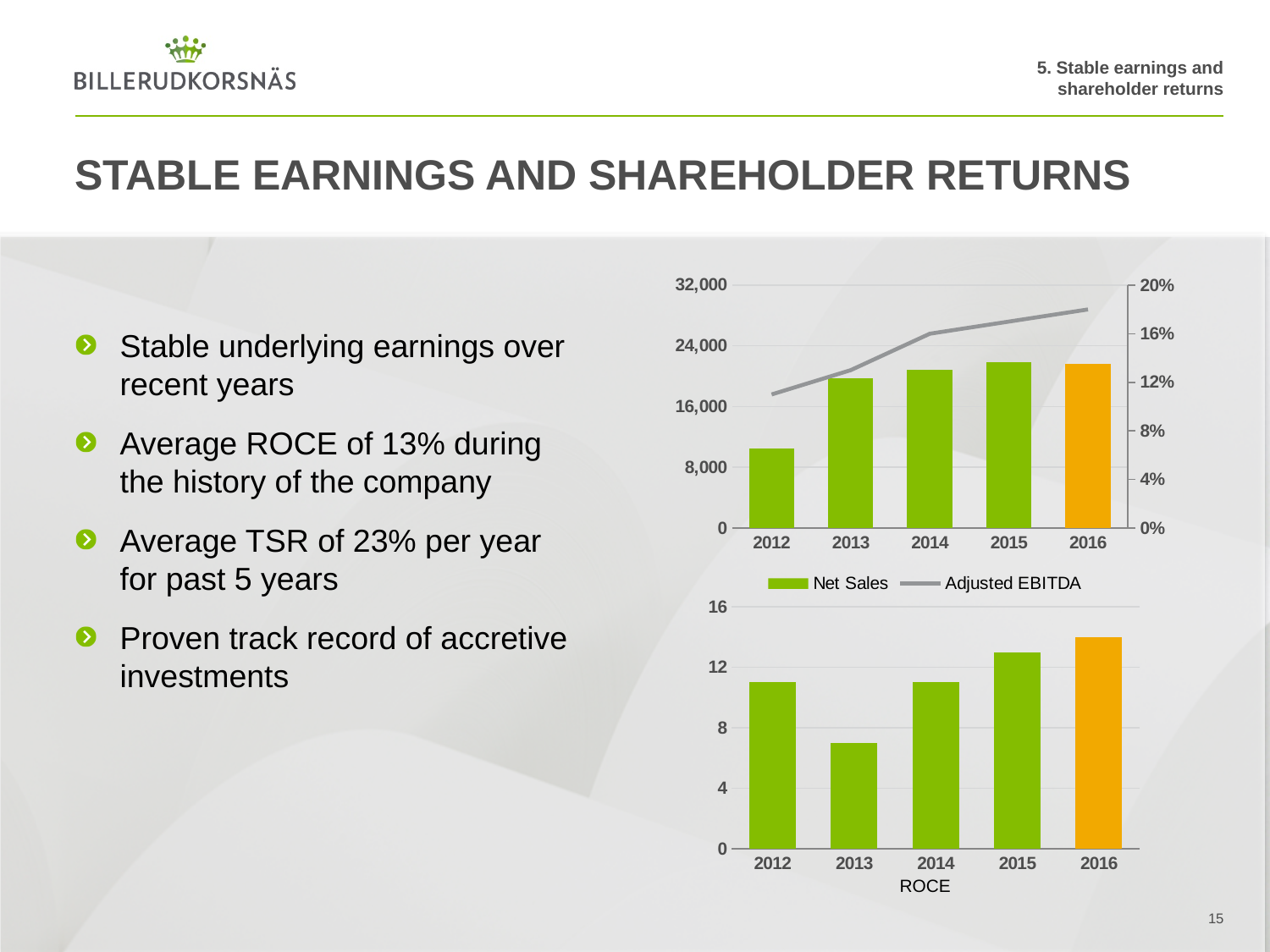
In the top chart, is the Net Sales value for 2012 greater or less than 16,000? less How many series does the legend of the top chart list? 2 In the top chart, which year has the lowest Net Sales? 2012 How many years are shown on the x axis of the bottom ROCE chart? 5 In the bottom ROCE chart, which year has the highest value? 2016 In the bottom ROCE chart, is the value for 2013 greater or less than 8? less In the top chart, which series is shown as a line? Adjusted EBITDA In the top chart, is the Net Sales value for 2015 greater or less than 16,000? greater In the top chart, does the Adjusted EBITDA line rise or fall from 2012 to 2016? rise In the bottom ROCE chart, which year has the lowest value? 2013